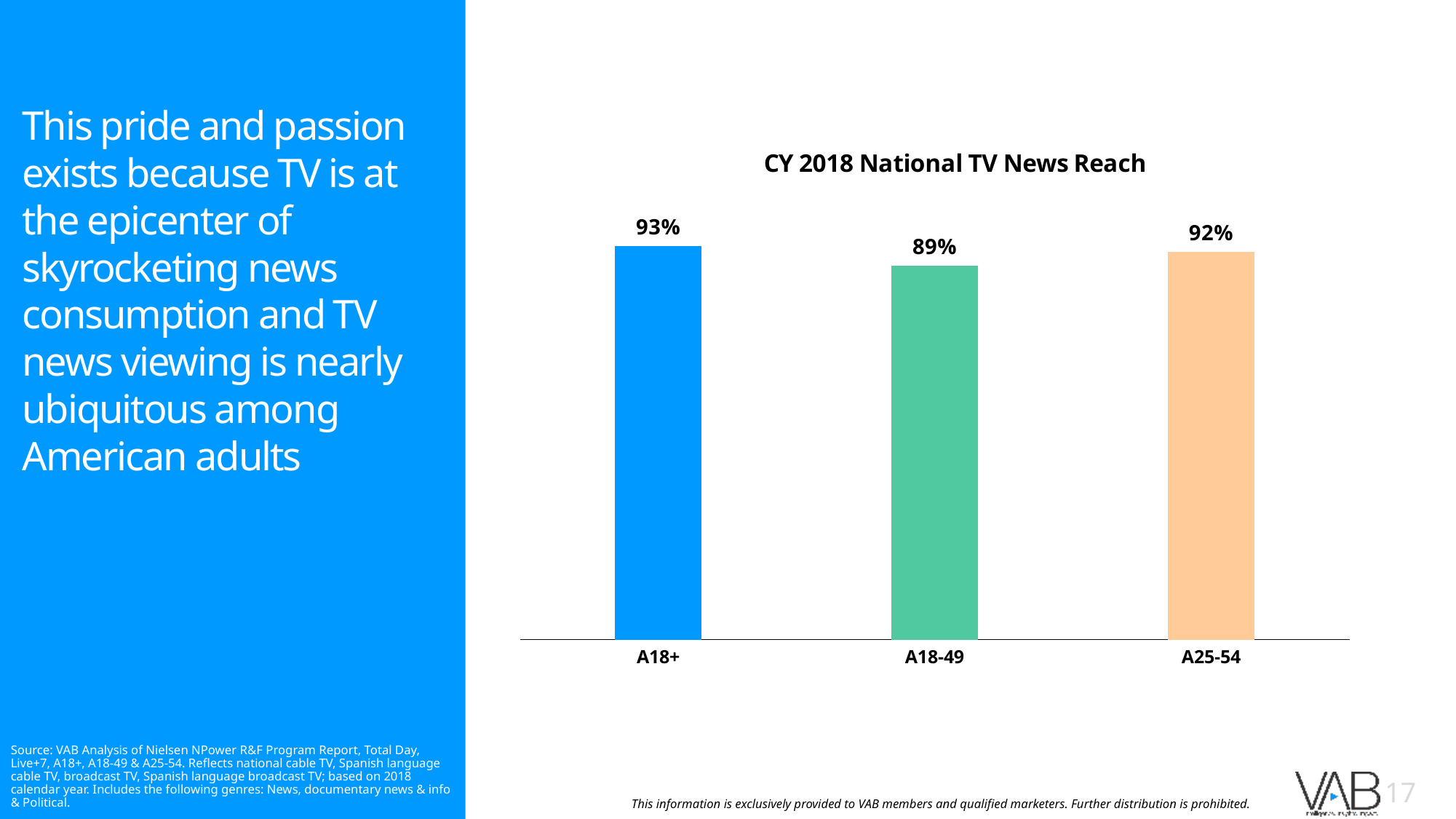
What is the difference in reach between A18+ and A18-49? 4 percentage points What is the national TV news reach for A18+? 93% Which demographic has the highest TV news reach? A18+ What is the national TV news reach for A18-49? 89% What is the difference in reach between A25-54 and A18-49? 3 percentage points How many demographic categories are shown in the chart? 3 Which demographic has the lowest TV news reach? A18-49 What type of chart is shown on the slide? Bar chart What colour is the bar for A18-49? Green Which has a higher reach, A18+ or A25-54? A18+ What is the national TV news reach for A25-54? 92% What is the title of the chart? CY 2018 National TV News Reach